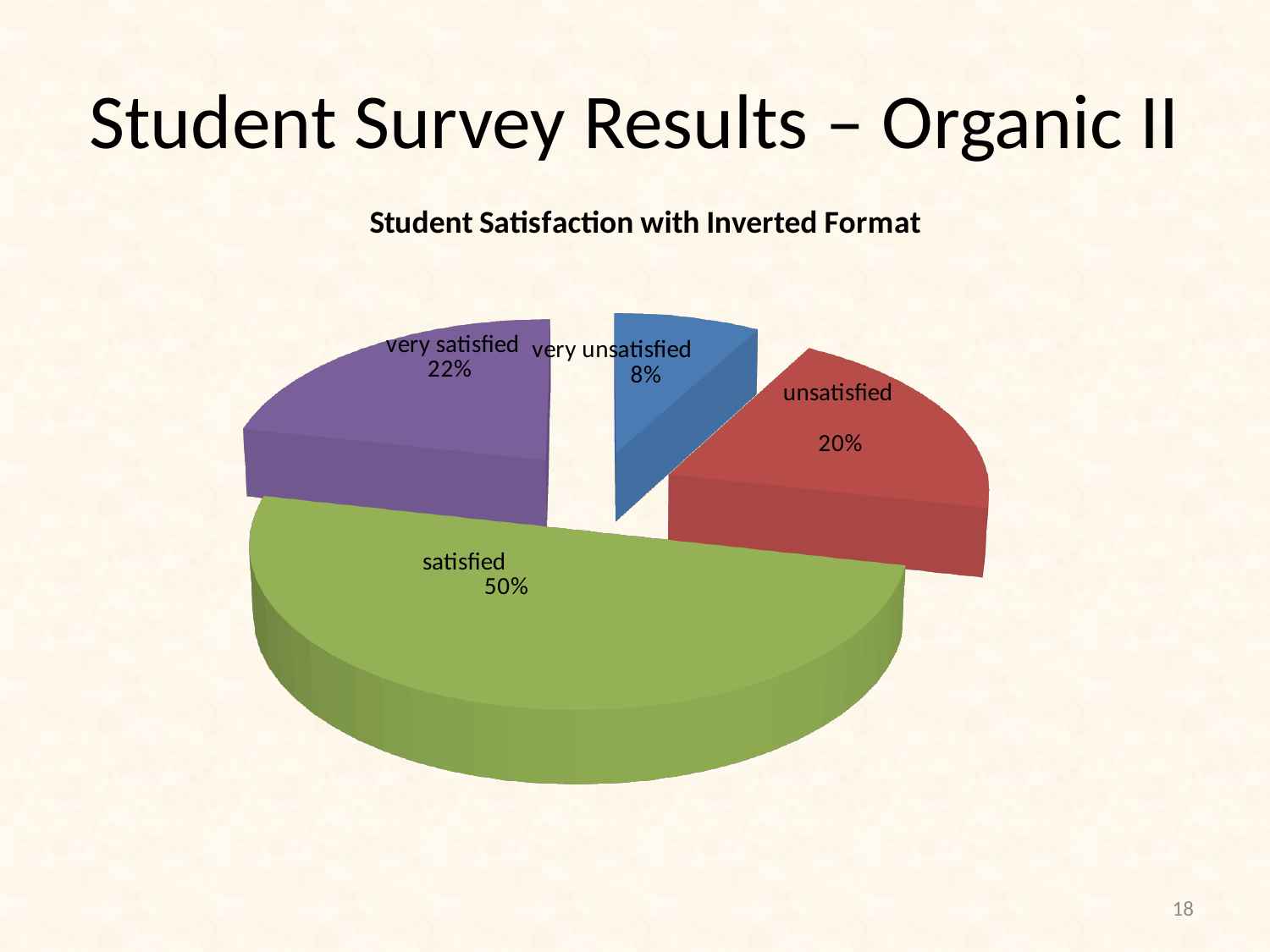
Which category has the smallest share of the pie? very unsatisfied What percentage of students were satisfied? 50% What colour is the slice for satisfied? green What kind of chart is shown on the slide? pie chart How many categories are shown in the pie chart? 4 What percentage of students were very unsatisfied? 8% What is the difference in percentage points between satisfied and very satisfied? 28 What percentage of students were unsatisfied? 20% What percentage of students were very satisfied? 22% Which is larger, the share for unsatisfied or the share for very satisfied? very satisfied What is the title of the chart? Student Satisfaction with Inverted Format Which category has the largest share of the pie? satisfied